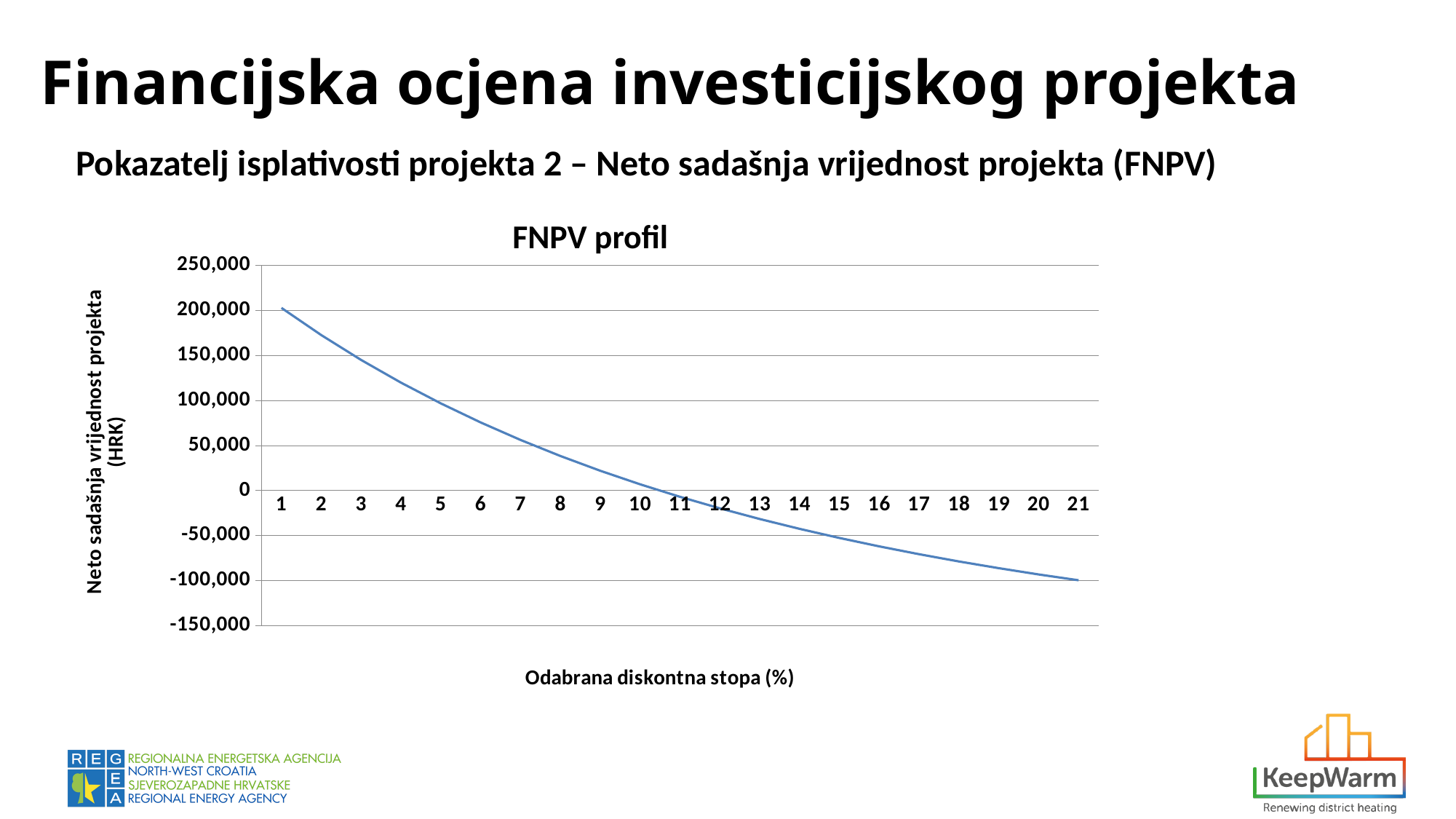
What is the title of the chart? FNPV profil Is the value at discount rate 12 greater or less than 0? less What kind of chart is shown on the slide? line chart Do the values rise or fall as the discount rate increases along the x axis? fall At which discount rate is the net present value lowest? 21 Is the value at discount rate 18 greater or less than -50,000? less Which is larger, the value at discount rate 5 or the value at discount rate 15? discount rate 5 At which discount rate is the net present value highest? 1 What is the label of the x axis of the chart? Odabrana diskontna stopa (%) Is the value at discount rate 1 greater or less than 150,000? greater How many discount rate values are plotted along the x axis? 21